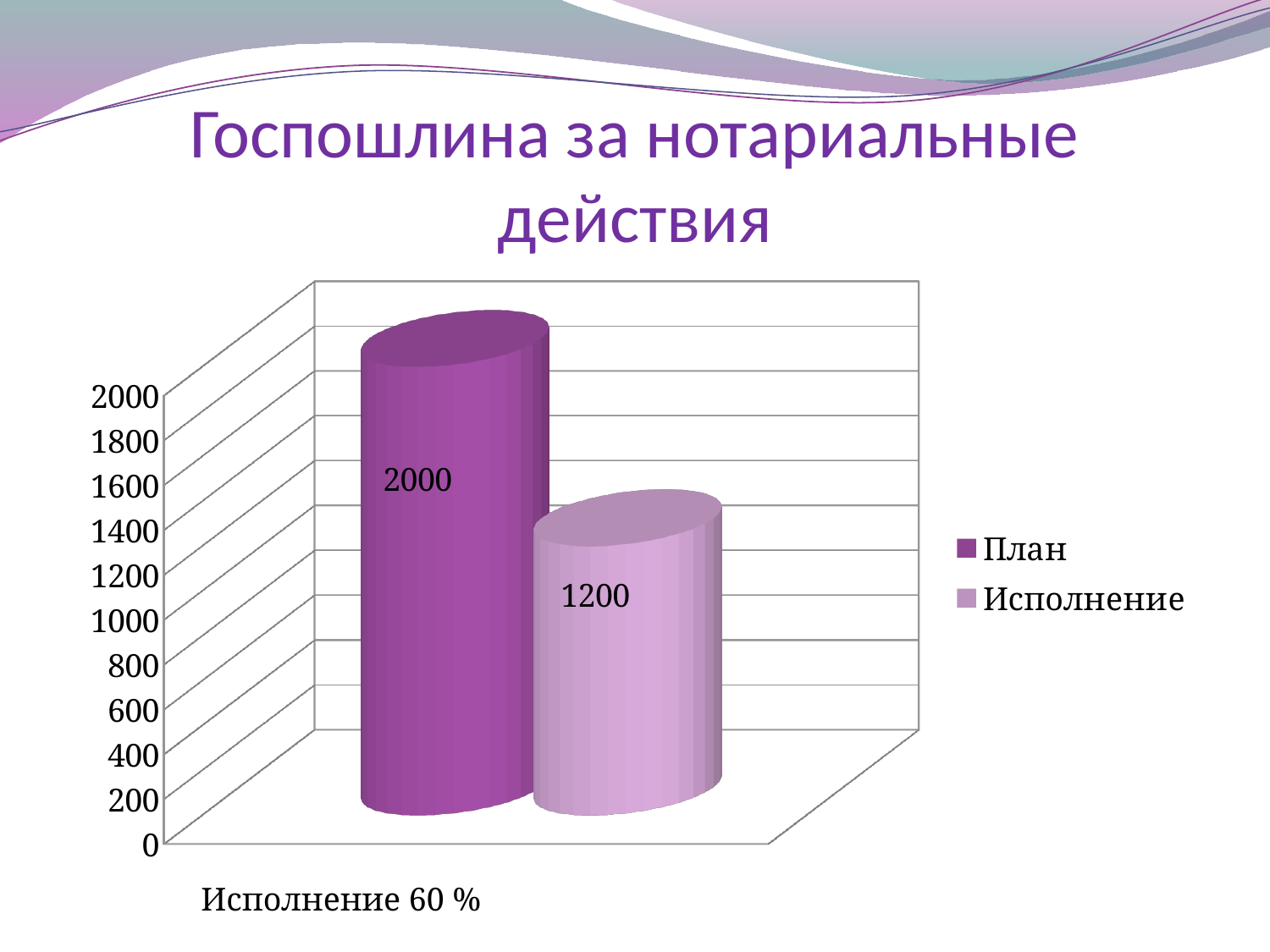
What is the difference between the План value and the Исполнение value? 800 How many series does the legend list? 2 What is the value for План? 2000 What kind of chart is shown on the slide? bar chart What is the value for Исполнение? 1200 What percentage of execution (Исполнение) is stated below the chart? 60 % How many bars are plotted on the chart? 2 Is the value for Исполнение greater or less than 1000? greater Which series has the lowest value? Исполнение What is the title of the chart? Госпошлина за нотариальные действия Which series has the higher value, План or Исполнение? План